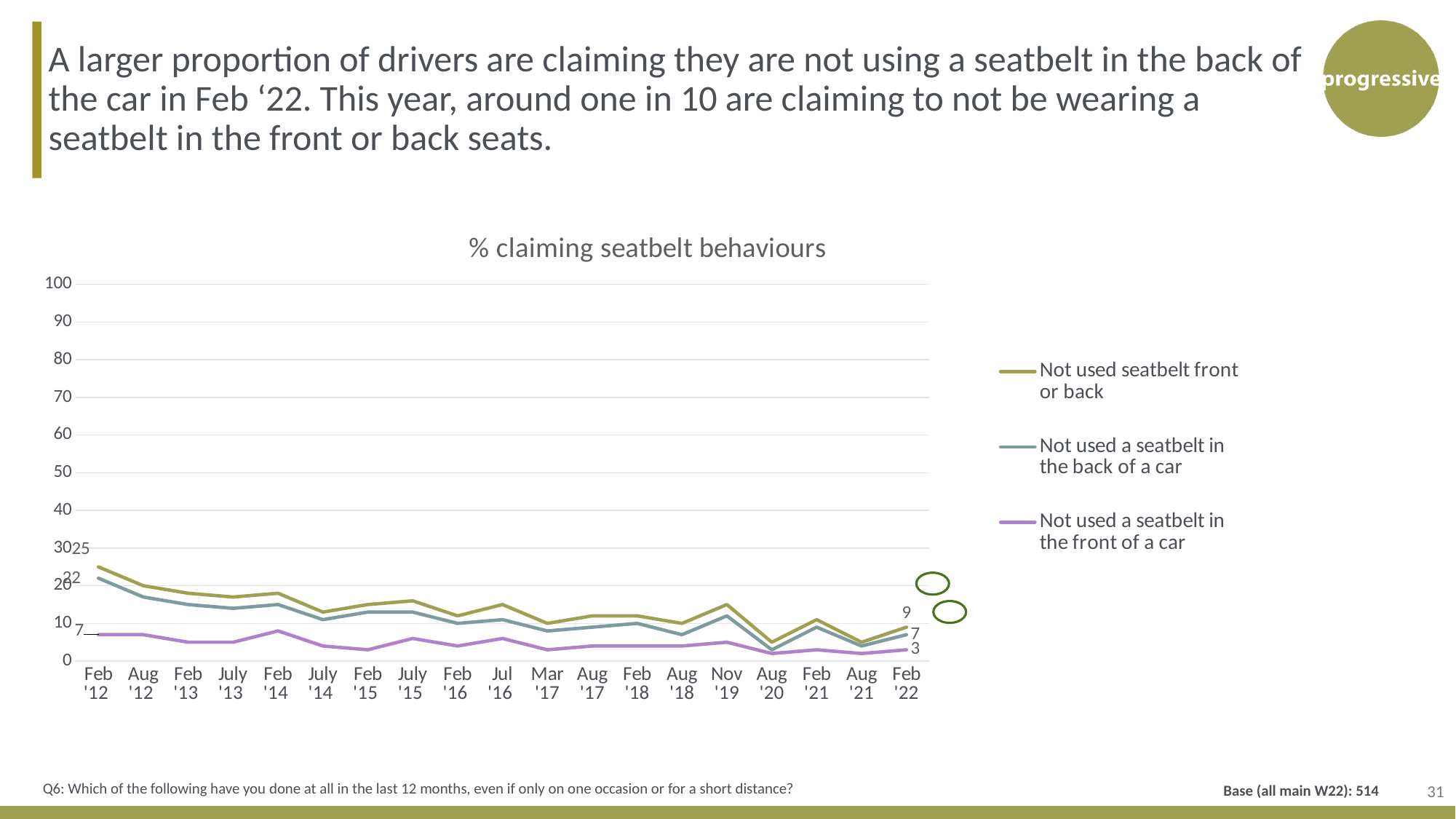
What is the value for 'Not used seatbelt front or back' in Feb '22? 9 Is the value for 'Not used seatbelt front or back' in Feb '12 greater or less than 20? greater Which series has the highest value in Feb '22? Not used seatbelt front or back What is the value for 'Not used a seatbelt in the front of a car' in Feb '22? 3 What is the value for 'Not used a seatbelt in the back of a car' in Feb '22? 7 How many time points are shown along the x axis? 19 How many series does the legend list? 3 What is the value for 'Not used a seatbelt in the front of a car' in Feb '12? 7 What is the difference between 'Not used seatbelt front or back' and 'Not used a seatbelt in the front of a car' in Feb '22? 6 What is the title of the chart? % claiming seatbelt behaviours In Feb '22, which is larger: 'Not used a seatbelt in the back of a car' or 'Not used a seatbelt in the front of a car'? Not used a seatbelt in the back of a car What kind of chart is shown on the slide? line chart